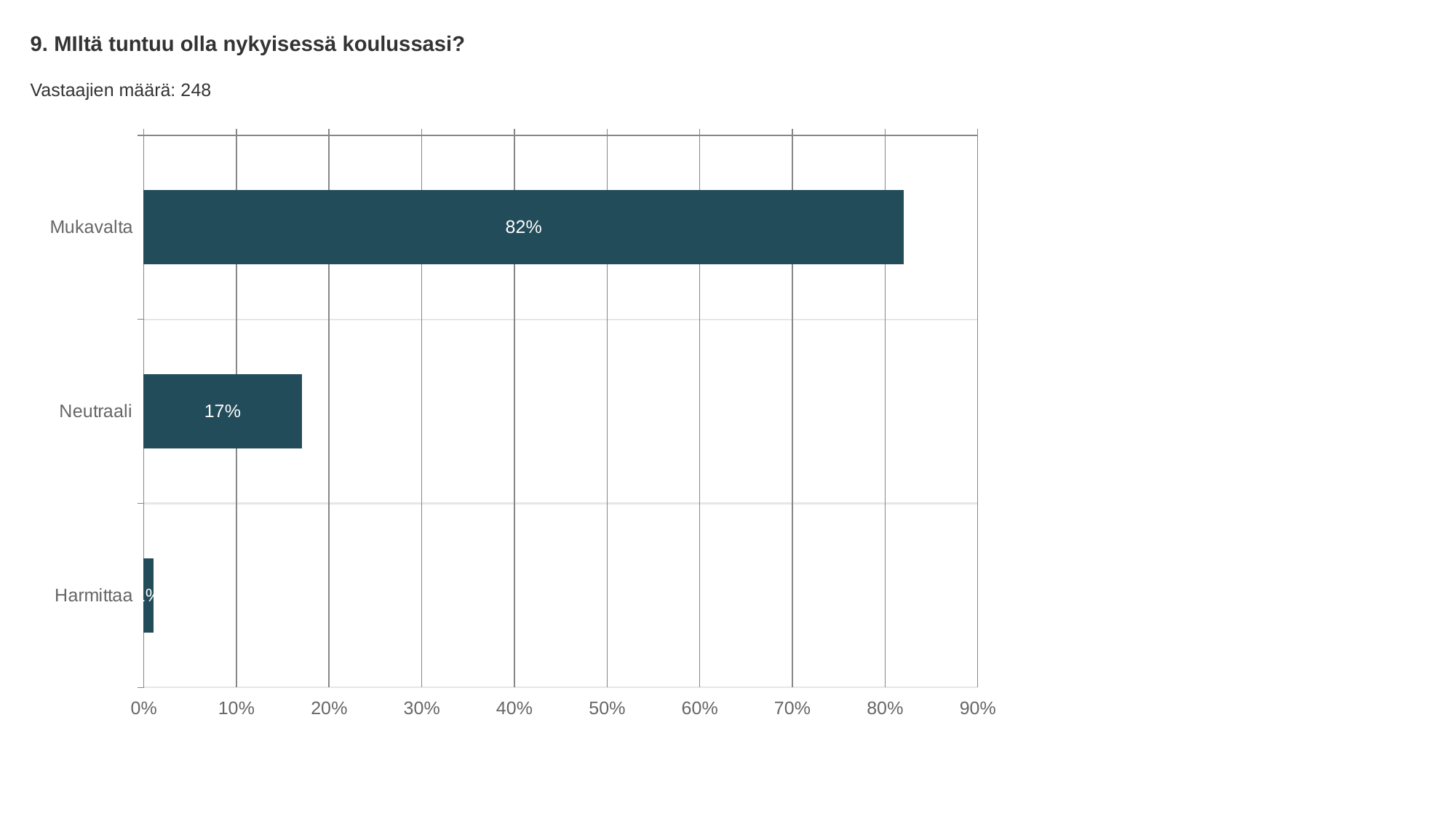
How many respondents (Vastaajien määrä) does the slide report? 248 Which is larger, the value for Neutraali or the value for Harmittaa? Neutraali How many categories are shown in the chart? 3 Which category has the lowest value? Harmittaa What is the value for Neutraali? 17% What is the title of the chart? 9. MIltä tuntuu olla nykyisessä koulussasi? What is the difference between the values for Mukavalta and Neutraali? 65% Is the value for Harmittaa greater or less than 10%? less What kind of chart is shown on the slide? bar chart Is the value for Neutraali greater or less than 20%? less Which category has the highest value? Mukavalta What is the value for Mukavalta? 82%